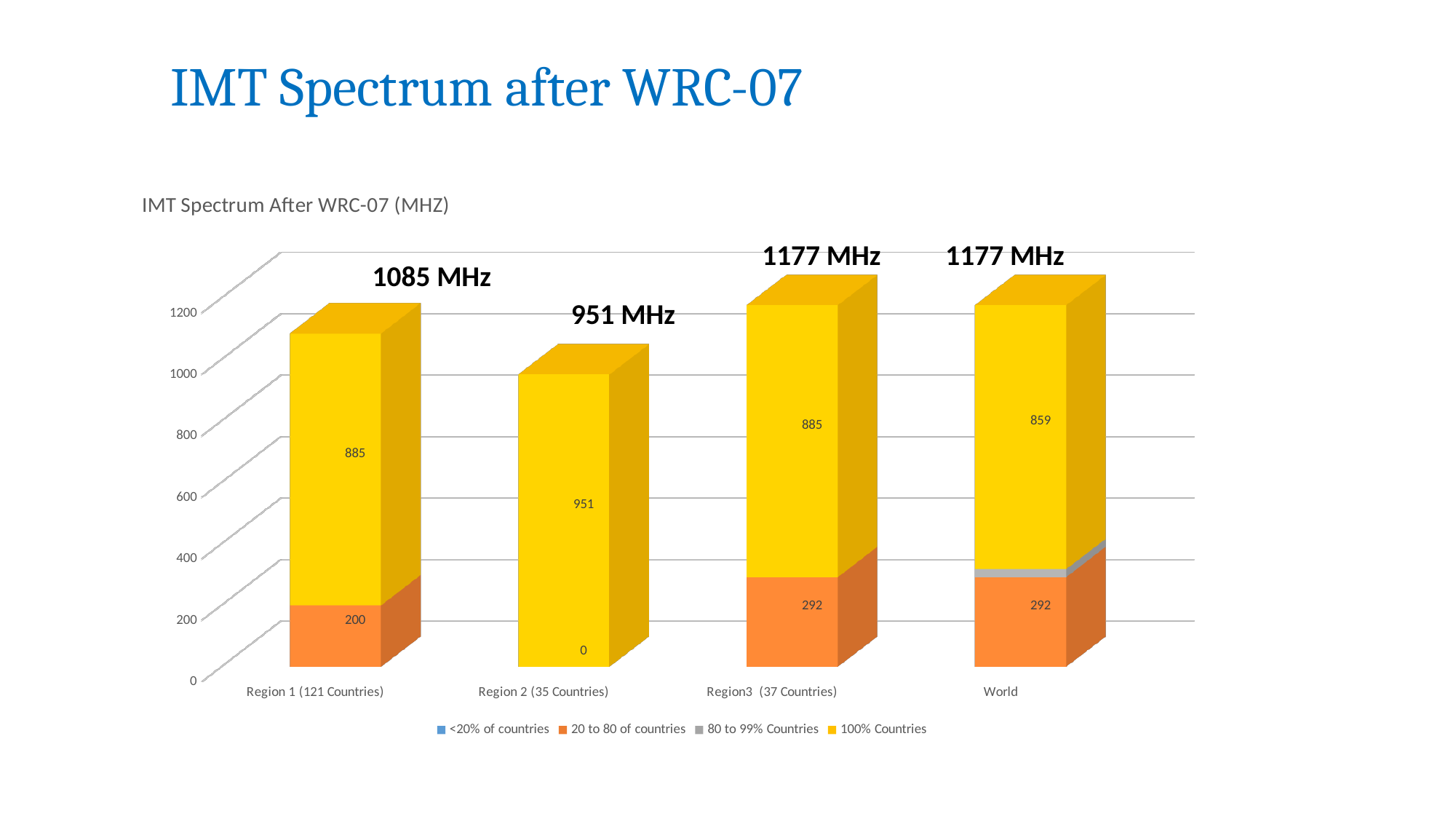
What is the value of the 20 to 80 of countries series for Region3 (37 Countries)? 292 How many categories are shown on the x axis? 4 What is the total IMT spectrum shown for Region 1 (121 Countries)? 1085 MHz What is the difference between the 100% Countries values for Region 2 (35 Countries) and World? 92 What kind of chart is shown on the slide? Stacked bar chart Which category has the lowest total IMT spectrum? Region 2 (35 Countries) What is the value of the 100% Countries series for Region 1 (121 Countries)? 885 How many series does the legend list? 4 What is the value of the 100% Countries series for World? 859 What is the total IMT spectrum shown for Region 2 (35 Countries)? 951 MHz What is the value of the 20 to 80 of countries series for Region 2 (35 Countries)? 0 Which is larger, the 20 to 80 of countries value for Region 1 (121 Countries) or for Region3 (37 Countries)? Region3 (37 Countries)